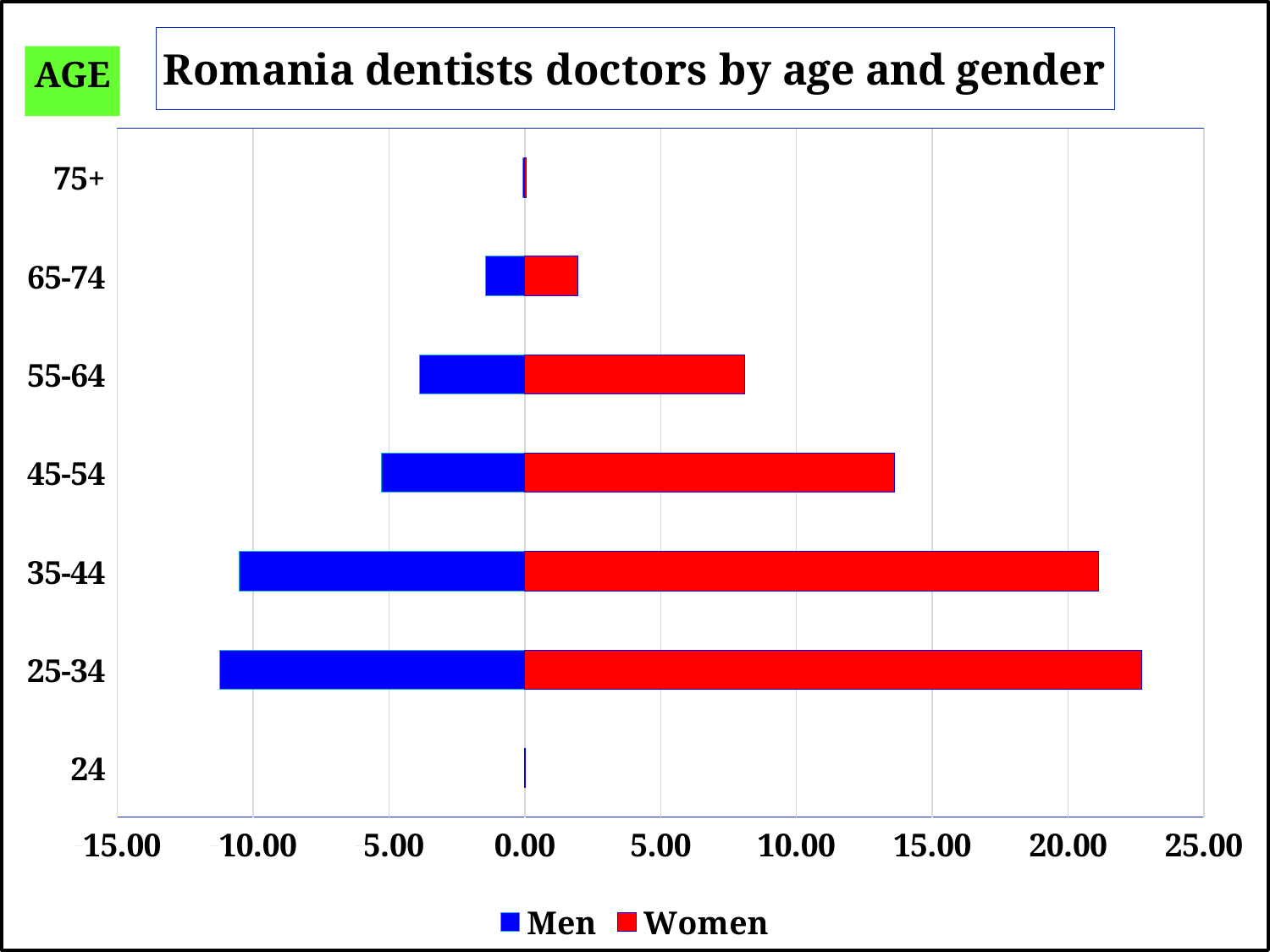
Is the Women value for the 25-34 age group greater or less than 20.00? greater Which colour represents the Men series? blue For the 45-54 age group, which series has the longer bar, Men or Women? Women Is the Women value for the 65-74 age group greater or less than 5.00? less Which age group has the longest Women bar? 25-34 How many series does the legend list? 2 What is the title of the chart? Romania dentists doctors by age and gender Is the Men bar for the 55-64 age group shorter or longer than 5.00? shorter Which age group has the longest Men bar? 25-34 How many age categories are shown on the vertical axis? 7 What type of chart is shown on the slide? bar chart